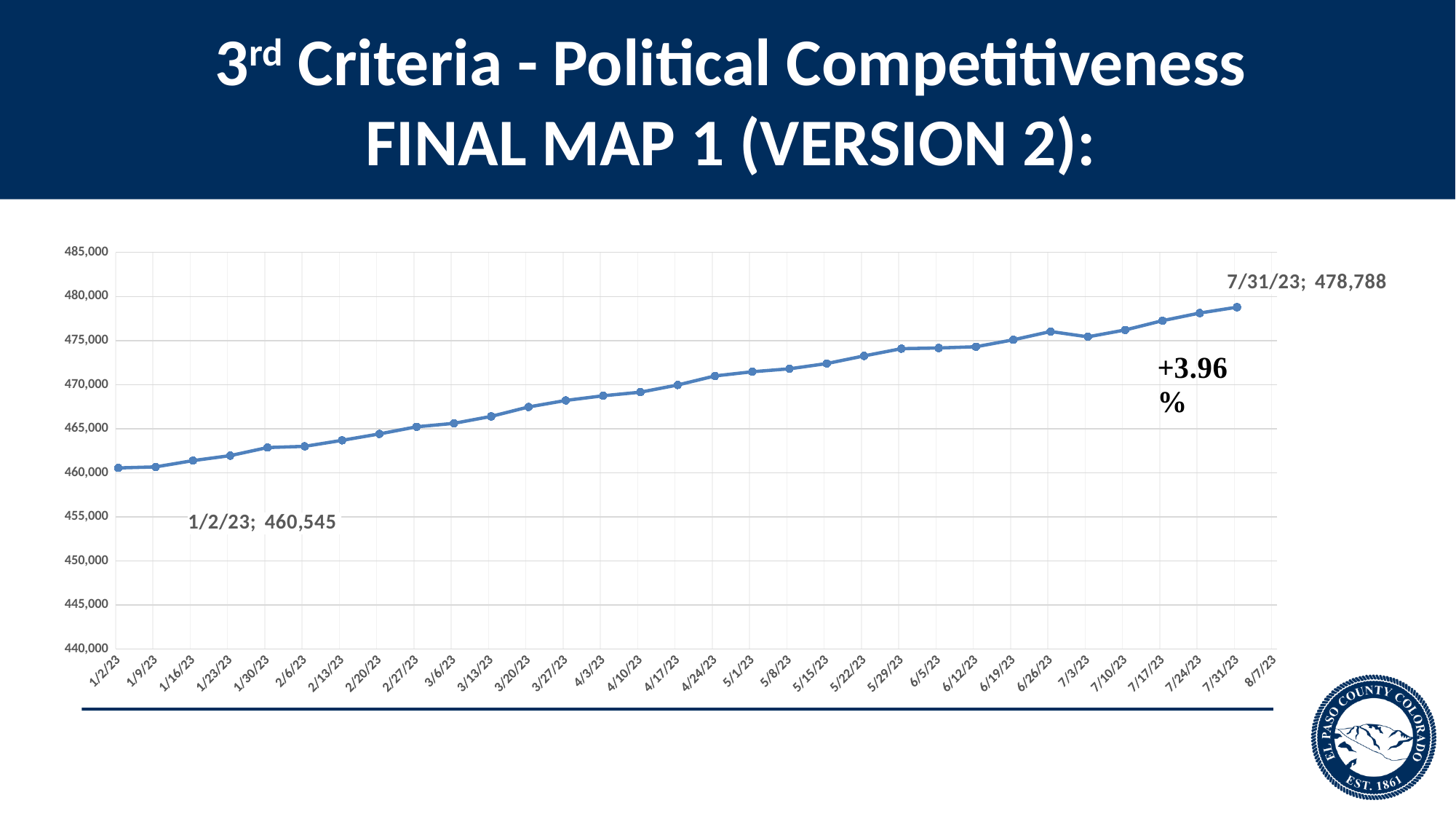
Which date has the highest plotted value? 7/31/23 What kind of chart is shown on the slide? Line chart Is the value for 2/6/23 greater or less than 465,000? less What is the value plotted for 1/2/23? 460,545 How many data points are plotted on the line? 31 What is the value plotted for 7/31/23? 478,788 Which is larger, the value on 1/2/23 or the value on 7/31/23? 7/31/23 What percentage change is annotated on the chart? +3.96% Is the value for 5/1/23 greater or less than 470,000? greater Do the values generally rise or fall from 1/2/23 to 7/31/23? Rise What is the difference between the value on 7/31/23 and the value on 1/2/23? 18,243 Is the value for 4/3/23 greater or less than 465,000? greater